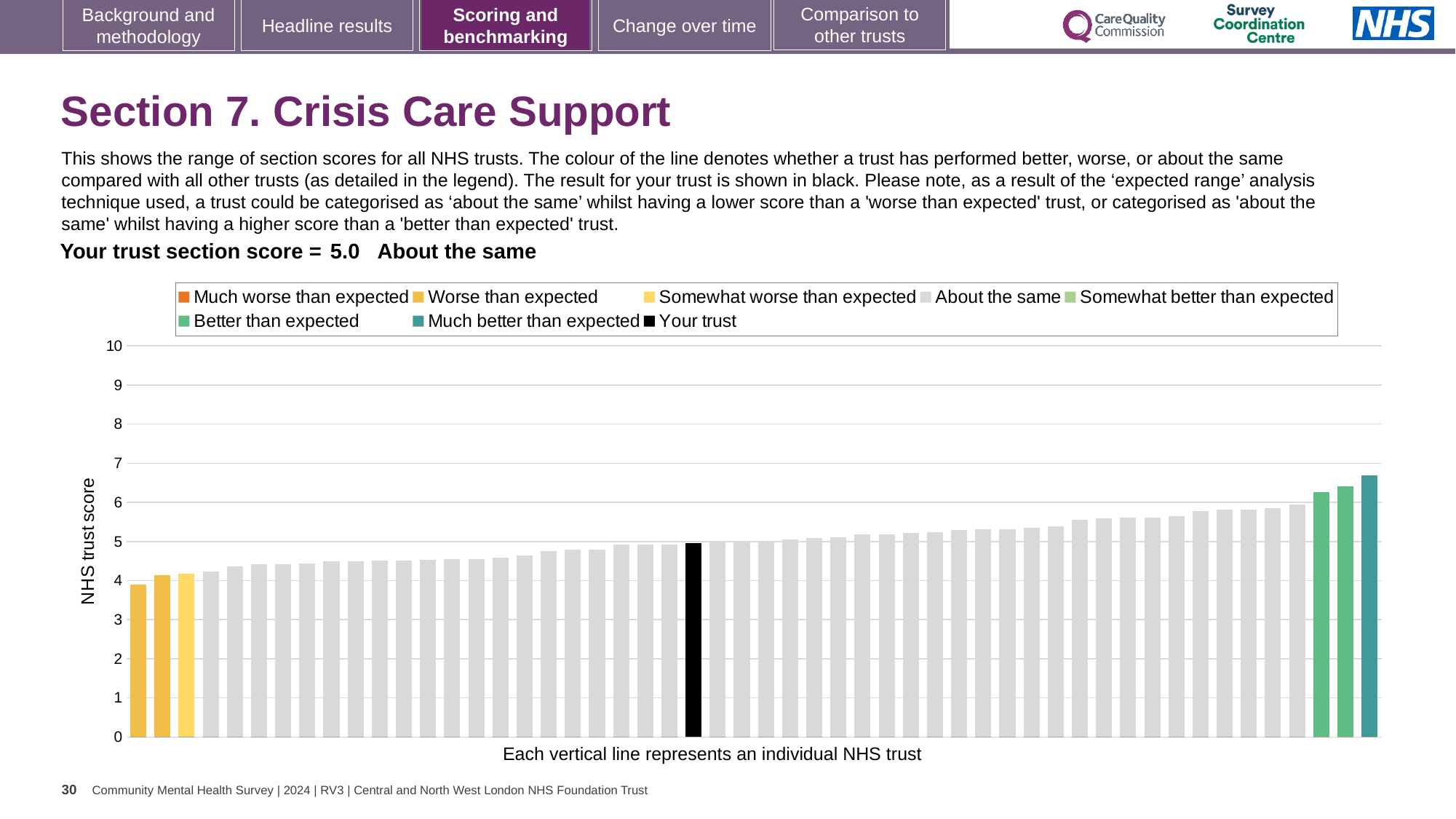
What is the section score for your trust shown on the slide? 5.0 How many bars are coloured as 'Better than expected'? 2 Do the bar values rise or fall from left to right along the x axis? rise What is the label on the vertical axis of the chart? NHS trust score Is the value of the tallest bar greater or less than 6? greater What colour is used for 'Your trust' in the chart? black Is the value of the shortest bar greater or less than 5? less What kind of chart is shown on the slide? bar chart What is the highest value shown on the vertical axis? 10 How many entries does the chart legend list? 8 How many bars are coloured as 'Much better than expected'? 1 Which category is your trust placed in for this section? About the same